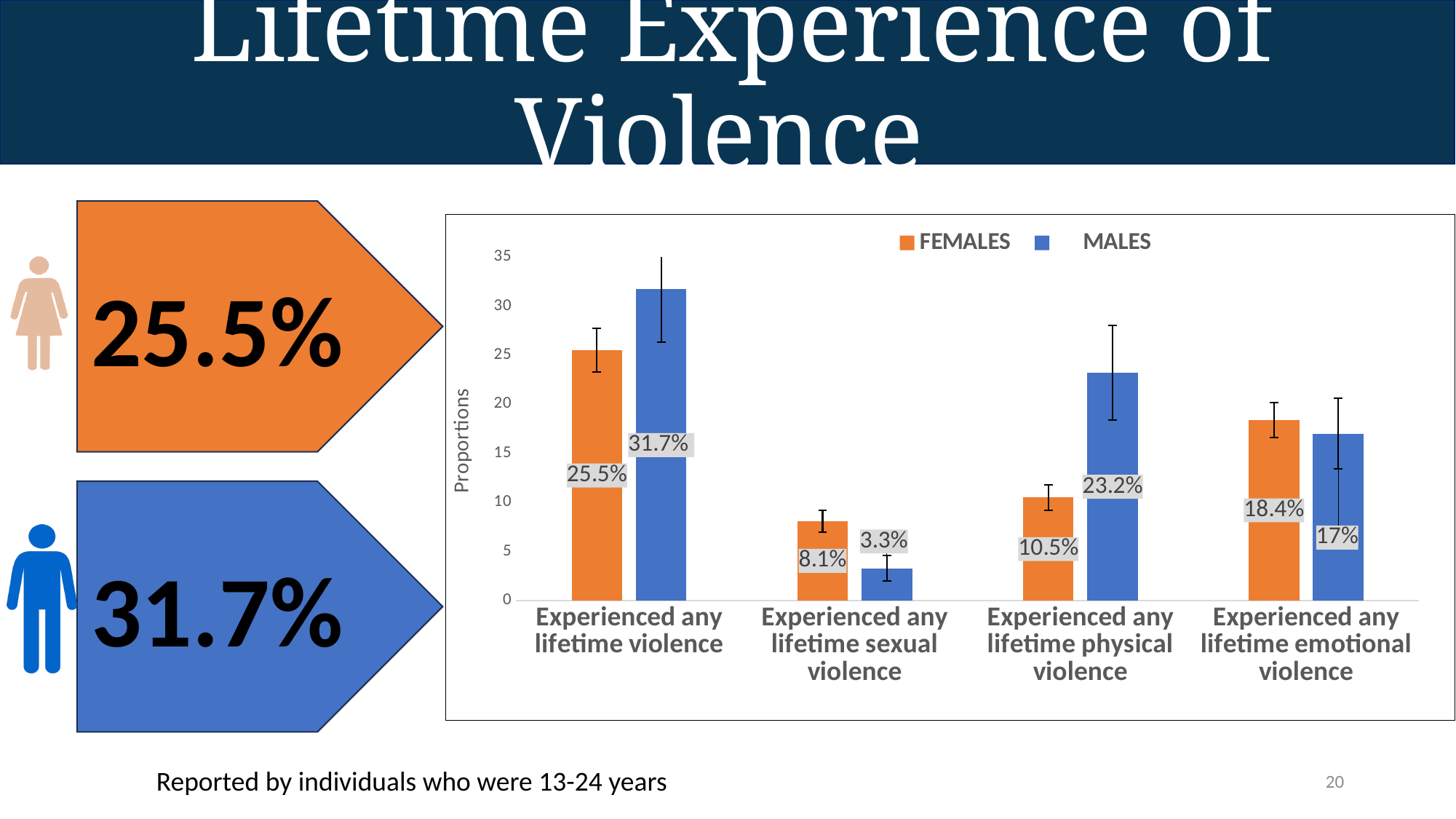
What is the difference between the MALES and FEMALES values for 'Experienced any lifetime physical violence'? 12.7% What is the value for FEMALES for 'Experienced any lifetime violence'? 25.5% What is the value for MALES for 'Experienced any lifetime physical violence'? 23.2% Is the MALES value for 'Experienced any lifetime violence' greater or less than 30? greater Which is larger for 'Experienced any lifetime emotional violence': the FEMALES value or the MALES value? FEMALES What kind of chart is shown on the slide? Bar chart Which category has the lowest value for FEMALES? Experienced any lifetime sexual violence How many categories are shown on the x axis? 4 Which category has the highest value for MALES? Experienced any lifetime violence What is the value for MALES for 'Experienced any lifetime sexual violence'? 3.3% How many series does the legend list? 2 What is the value for FEMALES for 'Experienced any lifetime emotional violence'? 18.4%